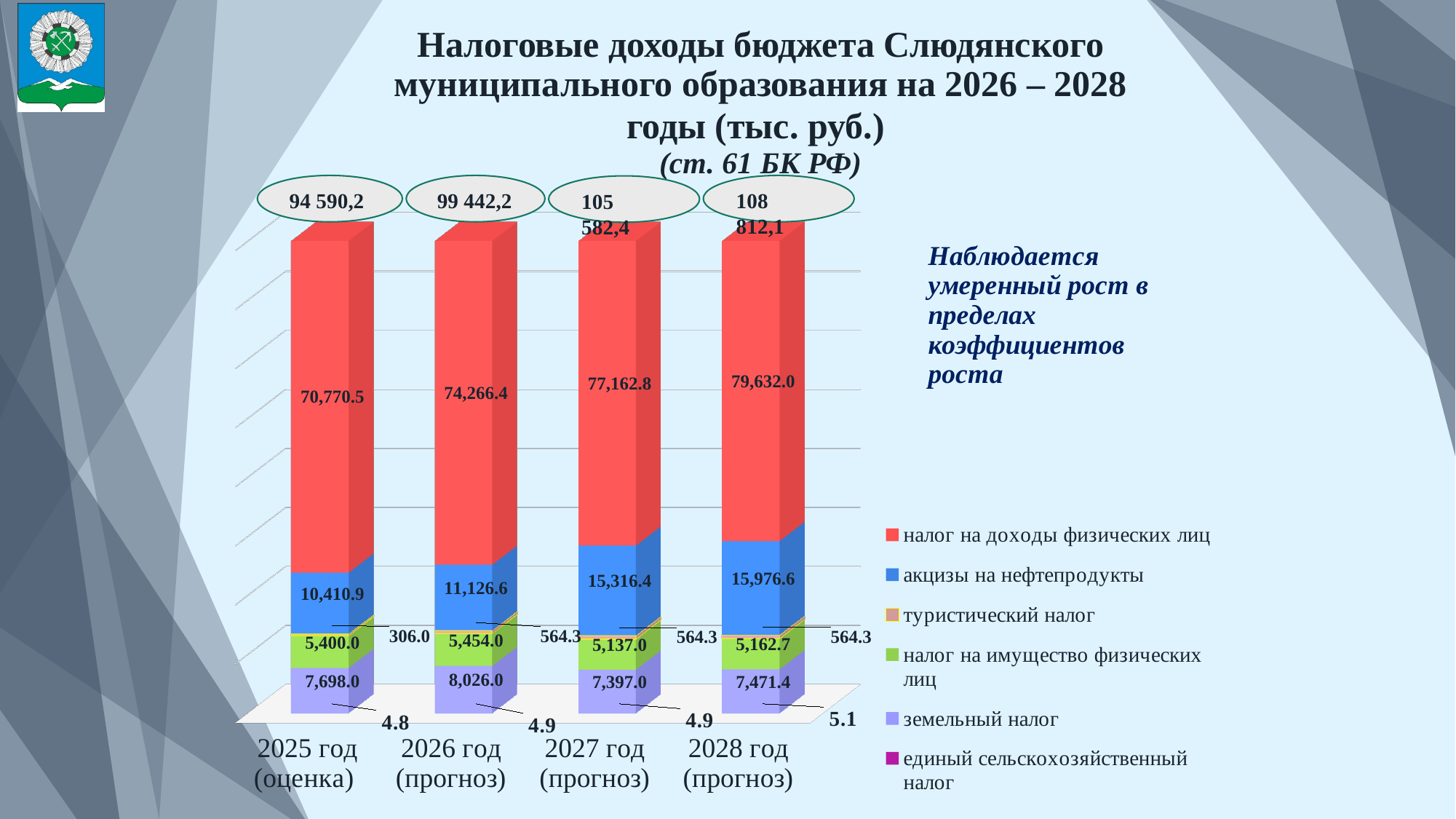
What is the total of the stacked bar for 2025 год (оценка), as shown in the oval above it? 94 590,2 Does налог на доходы физических лиц rise or fall from 2025 to 2028? Rises How many year categories are shown on the x axis of the chart? 4 In which year is земельный налог the lowest? 2027 год (прогноз) What is the value of акцизы на нефтепродукты for 2026 год (прогноз)? 11,126.6 How many series does the chart legend list? 6 What kind of chart is shown on the slide? Stacked bar chart What is the value of земельный налог for 2028 год (прогноз)? 7,471.4 What is the value of туристический налог for 2025 год (оценка)? 306.0 What is the value of налог на доходы физических лиц for 2027 год (прогноз)? 77,162.8 What is the difference between налог на доходы физических лиц in 2028 год (прогноз) and in 2025 год (оценка)? 8,861.5 In which year is налог на доходы физических лиц the highest? 2028 год (прогноз)